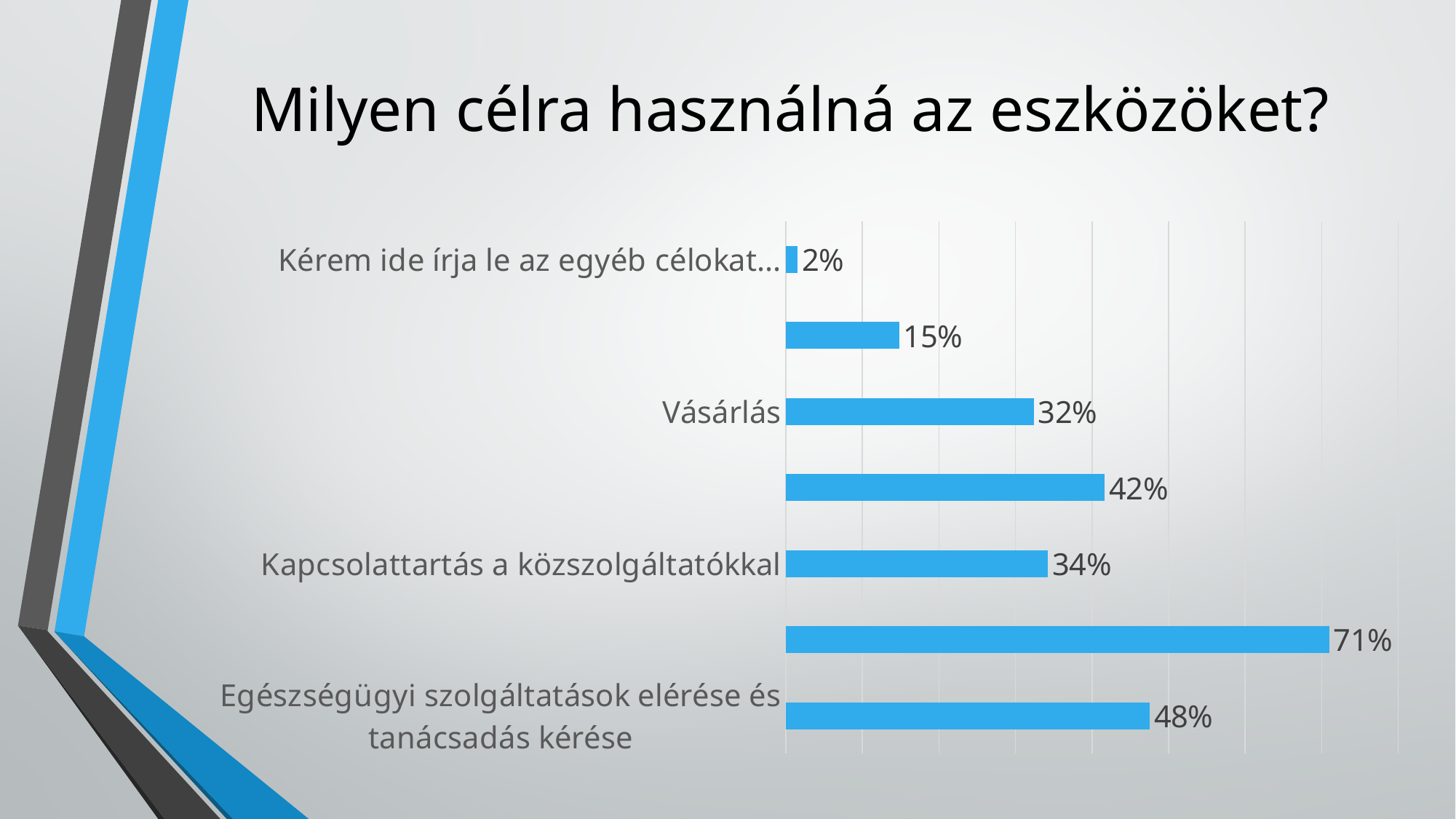
What is the value for Egészségügyi szolgáltatások elérése és tanácsadás kérése? 48% What is the title of the chart? Milyen célra használná az eszközöket? Which is larger: the value for Egészségügyi szolgáltatások elérése és tanácsadás kérése or the value for Vásárlás? Egészségügyi szolgáltatások elérése és tanácsadás kérése What type of chart is shown on the slide? bar chart What is the value for Kapcsolattartás a közszolgáltatókkal? 34% What colour are the bars in the chart? blue What is the lowest value shown in the chart? 2% What is the value for Vásárlás? 32% What is the difference between the value for Egészségügyi szolgáltatások elérése és tanácsadás kérése and the value for Vásárlás? 16% What is the value for Kérem ide írja le az egyéb célokat...? 2% How many bars are plotted in the chart? 7 What is the highest value shown in the chart? 71%